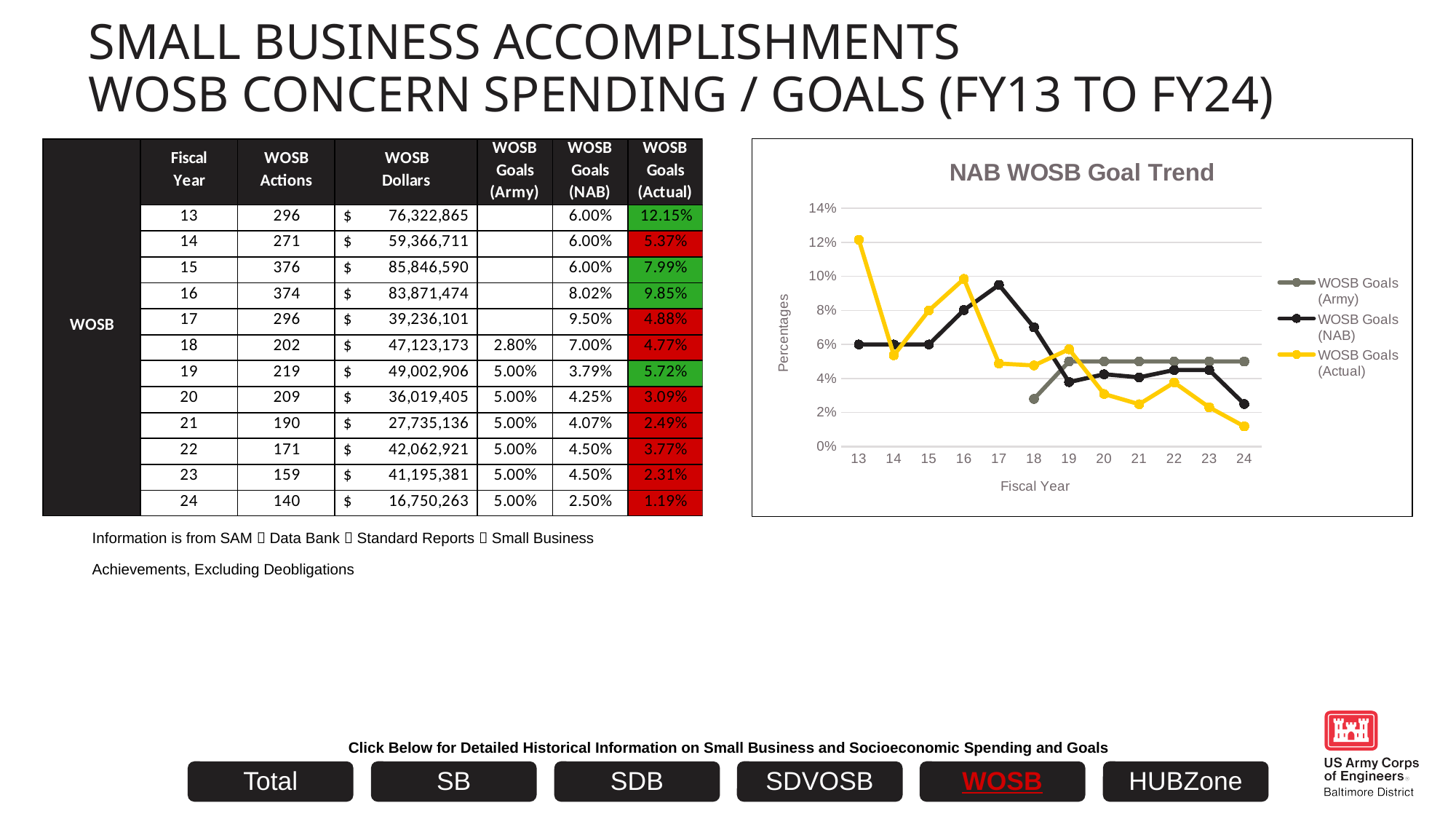
How many series does the legend of the NAB WOSB Goal Trend chart list? 3 In the NAB WOSB Goal Trend chart, does the WOSB Goals (NAB) line rise or fall from fiscal year 17 to fiscal year 24? fall What is the difference between WOSB Goals (Actual) and WOSB Goals (NAB) for fiscal year 13, using the values in the table? 6.15% In the NAB WOSB Goal Trend chart, in which fiscal year is WOSB Goals (Actual) lowest? 24 What kind of chart is the NAB WOSB Goal Trend chart? line chart What colour is the WOSB Goals (Actual) line in the NAB WOSB Goal Trend chart? yellow In the NAB WOSB Goal Trend chart, is the WOSB Goals (Actual) value for fiscal year 24 greater or less than 2%? less What is the WOSB Goals (NAB) value for fiscal year 19, as shown in the table on the slide? 3.79% In the NAB WOSB Goal Trend chart, in which fiscal year is WOSB Goals (Actual) highest? 13 In the NAB WOSB Goal Trend chart, is the WOSB Goals (NAB) value for fiscal year 17 greater or less than 8%? greater In the NAB WOSB Goal Trend chart, which is larger in fiscal year 16: WOSB Goals (Actual) or WOSB Goals (NAB)? WOSB Goals (Actual) How many fiscal years are shown on the x axis of the NAB WOSB Goal Trend chart? 12